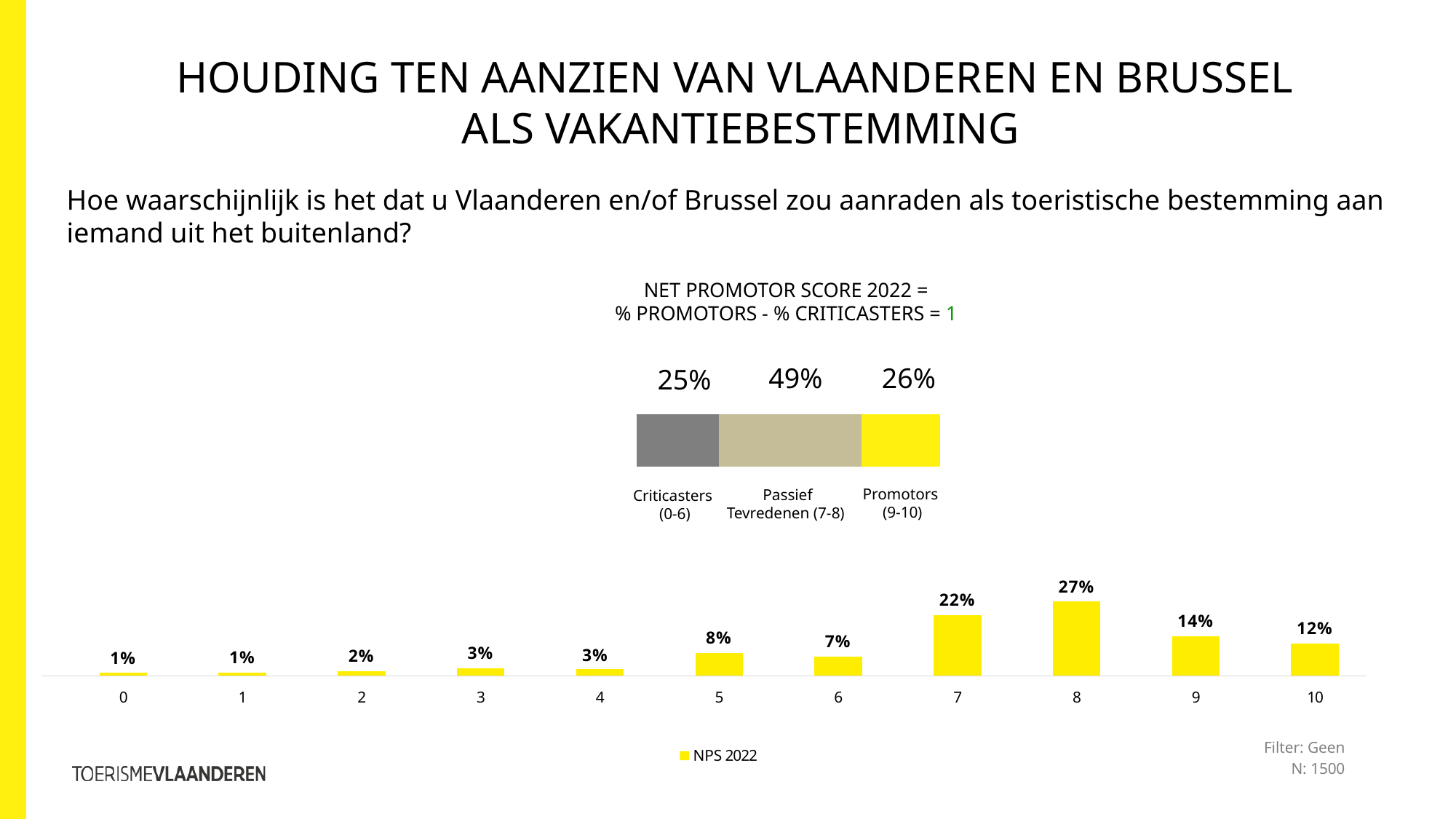
How many score categories are shown on the x axis of the bottom bar chart? 11 In the bottom bar chart, what is the value for score 8? 27% In the bottom bar chart, which score has the highest value? 8 In the bottom bar chart, what is the value for score 10? 12% What is the name of the series in the legend of the bottom bar chart? NPS 2022 What kind of chart is the bottom chart on the slide? bar chart In the stacked bar in the middle of the slide, what is the share for Passief Tevredenen (7-8)? 49% In the bottom bar chart, what is the difference between the values for score 7 and score 9? 8% In the bottom bar chart, what is the value for score 5? 8% In the stacked bar in the middle of the slide, which segment is the largest? Passief Tevredenen (7-8) In the bottom bar chart, which is larger: the value for score 5 or the value for score 6? score 5 How many series does the legend of the bottom bar chart list? 1